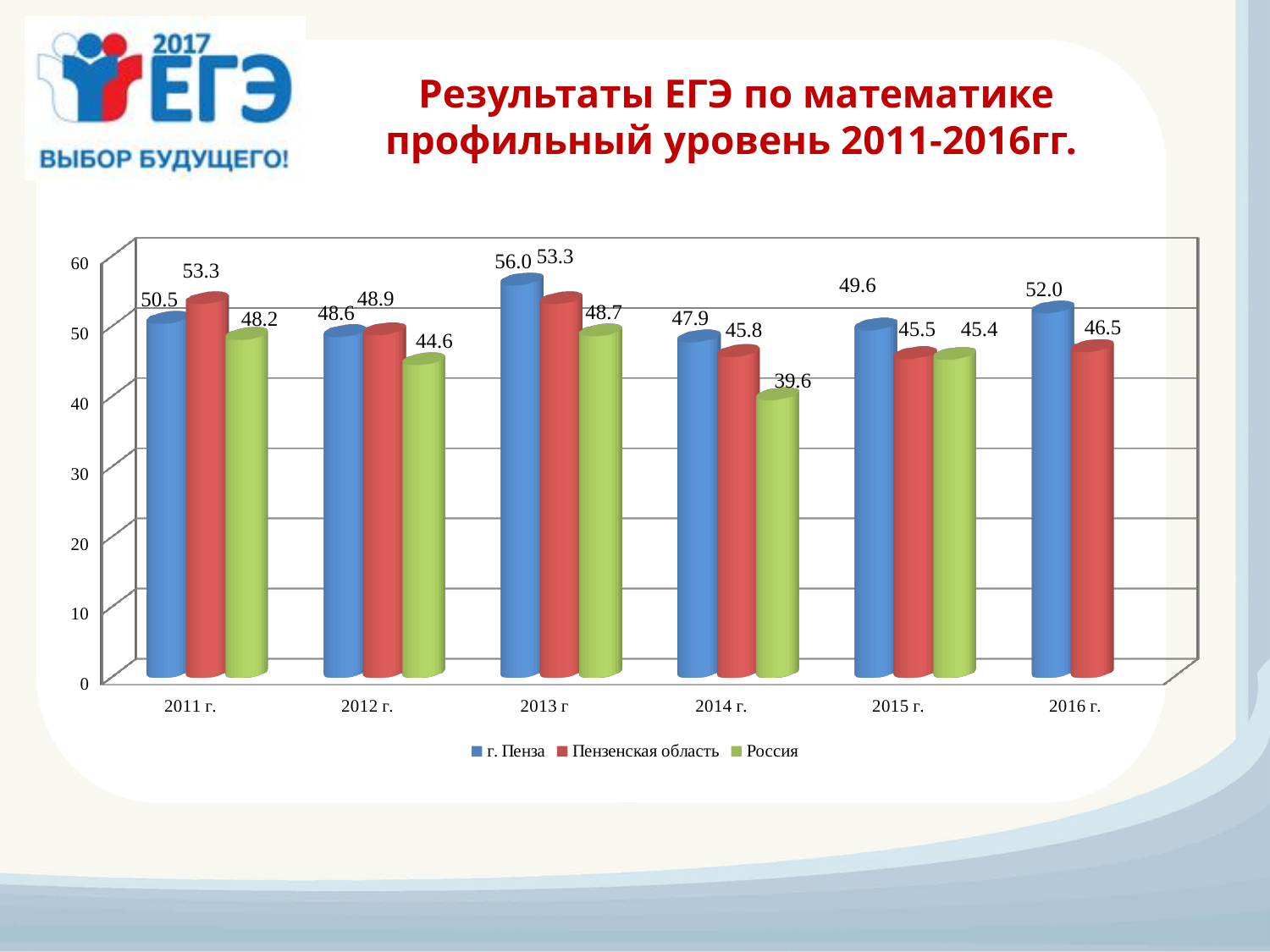
What is the value for г. Пенза in 2013 г? 56.0 How many series does the legend list? 3 What is the value for Россия in 2014 г.? 39.6 In which year is the value for г. Пенза the highest? 2013 г What is the value for Пензенская область in 2016 г.? 46.5 Which series is shown in green? Россия What is the difference between г. Пенза and Россия in 2014 г.? 8.3 What kind of chart is shown on the slide? Bar chart In which year is the value for Россия the lowest? 2014 г. Which is larger in 2011 г.: г. Пенза or Пензенская область? Пензенская область What is the difference between г. Пенза and Пензенская область in 2016 г.? 5.5 How many years are shown on the x axis? 6